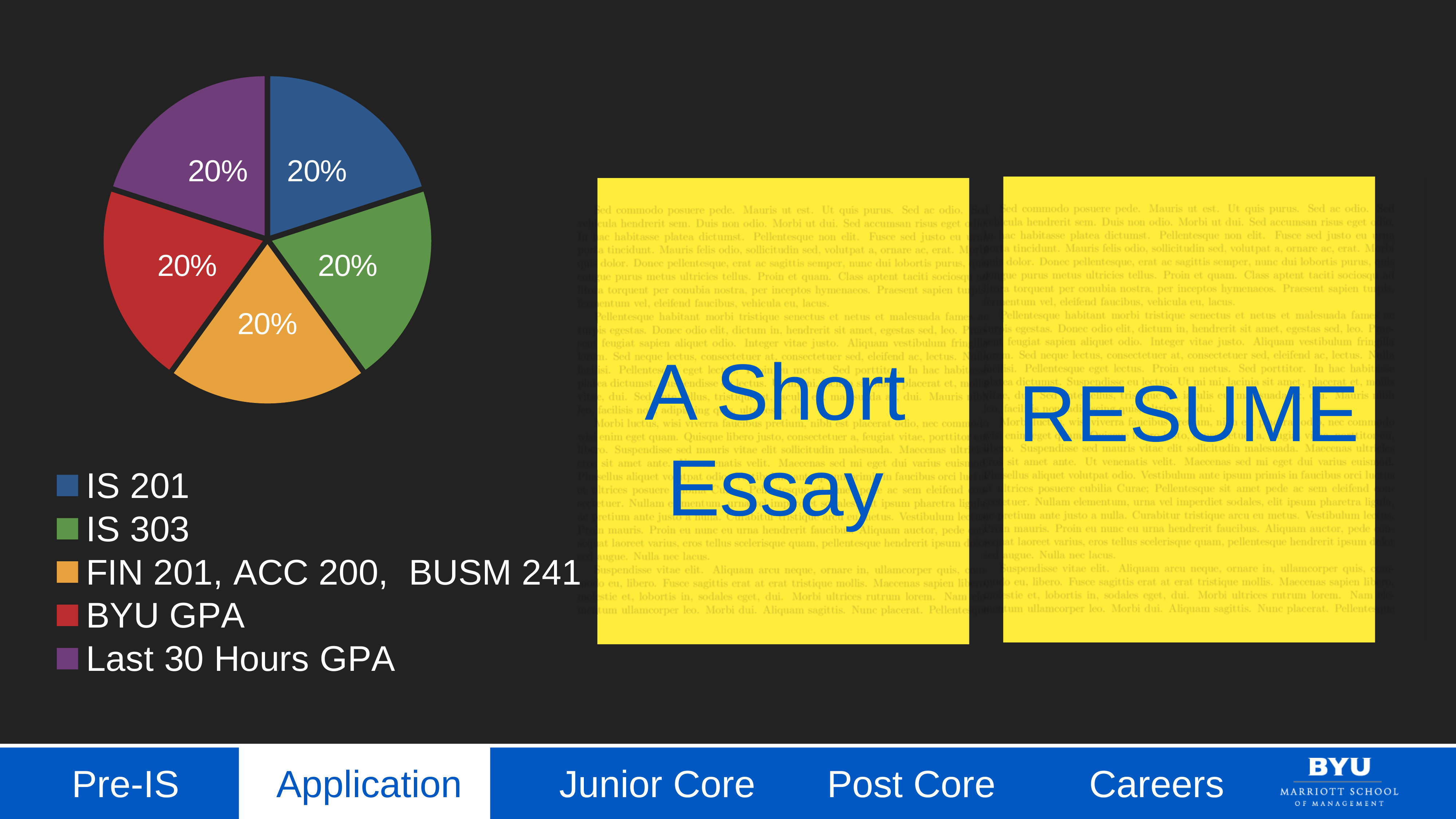
What kind of chart is shown on the slide? pie chart What is the value shown for the FIN 201, ACC 200, BUSM 241 slice? 20% Which legend entry is shown in purple? Last 30 Hours GPA What is the value shown for the Last 30 Hours GPA slice? 20% Which colour represents BYU GPA in the pie chart? red What is the value shown for the IS 303 slice? 20% What share of the pie does IS 201 represent? 20% How many entries does the legend of the pie chart list? 5 How many slices does the pie chart have? 5 What is the difference between the IS 201 slice and the BYU GPA slice? 0% What share of the pie does BYU GPA represent? 20%